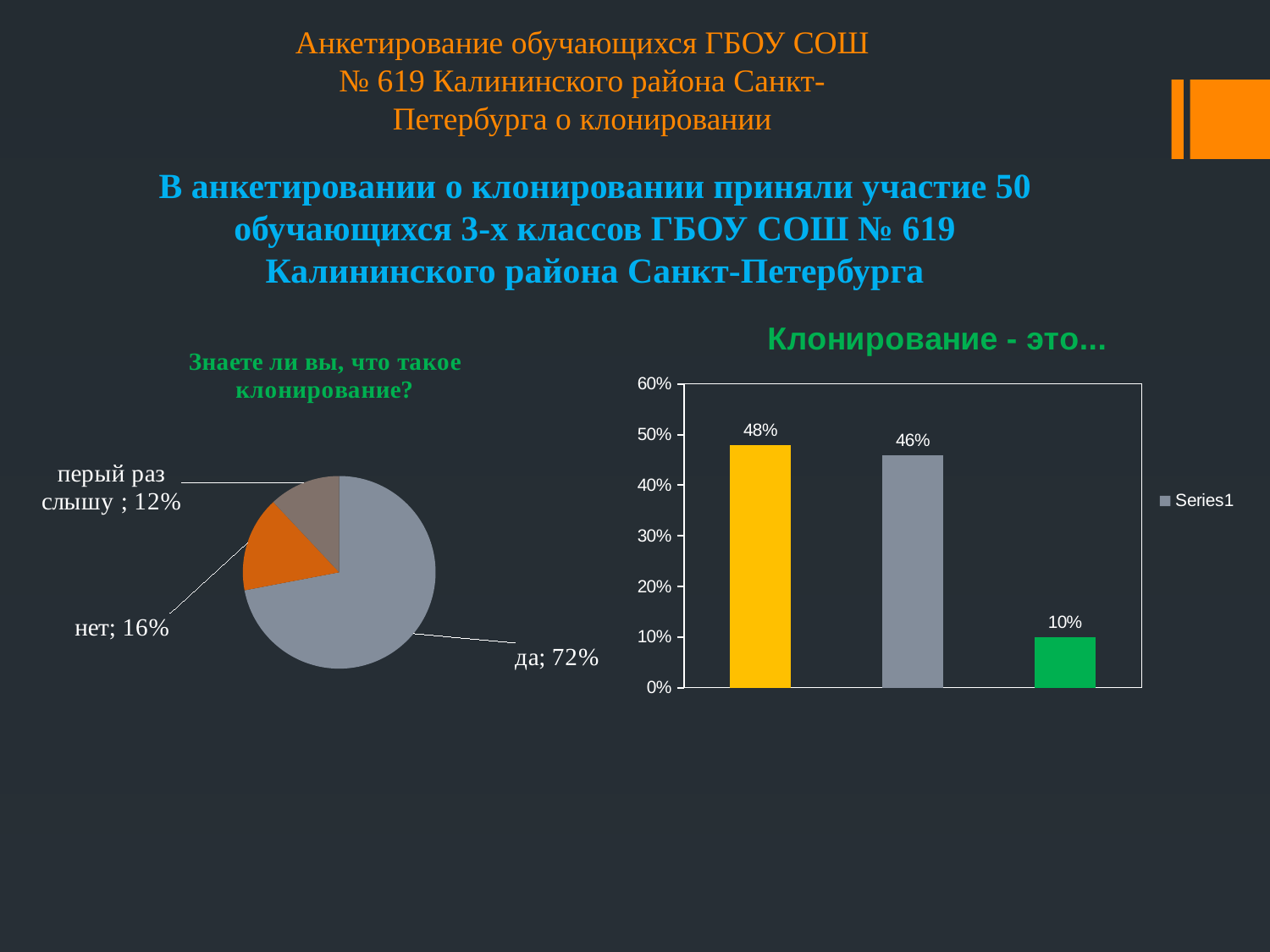
In the pie chart "Знаете ли вы, что такое клонирование?", what share is labelled "перый раз слышу"? 12% What kind of chart is the chart titled "Клонирование - это..."? bar chart In the pie chart "Знаете ли вы, что такое клонирование?", what share of respondents answered "да"? 72% In the bar chart "Клонирование - это...", how many series does the legend list? 1 In the pie chart "Знаете ли вы, что такое клонирование?", how many slices are there? 3 In the pie chart "Знаете ли вы, что такое клонирование?", what share of respondents answered "нет"? 16% In the bar chart "Клонирование - это...", what is the value of the third (green) bar? 10% In the pie chart "Знаете ли вы, что такое клонирование?", which answer has the largest slice? да In the pie chart "Знаете ли вы, что такое клонирование?", what is the difference between the "да" share and the "нет" share? 56% In the bar chart "Клонирование - это...", what is the value of the first (yellow) bar? 48% In the pie chart "Знаете ли вы, что такое клонирование?", which answer has the smallest slice? перый раз слышу In the bar chart "Клонирование - это...", what is the difference between the second (grey) bar and the third (green) bar? 36%